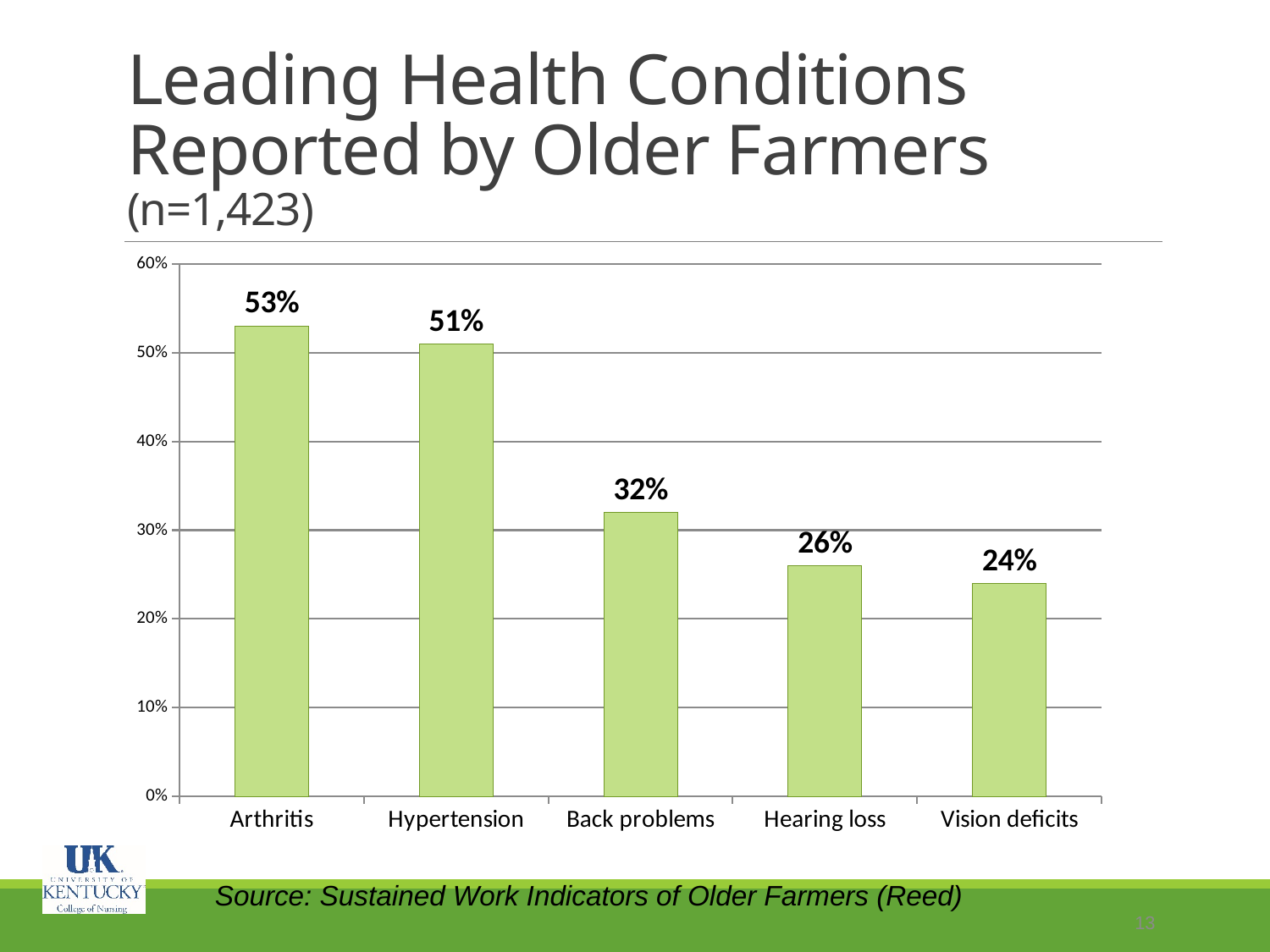
What percentage of older farmers reported arthritis? 53% What is the difference in percentage points between Arthritis and Hypertension? 2 Which is larger, the value for Hearing loss or the value for Vision deficits? Hearing loss Which health condition has the lowest reported percentage? Vision deficits Which health condition has the highest reported percentage? Arthritis What percentage is shown for Back problems? 32% What kind of chart is shown on the slide? Bar chart How many health conditions are shown on the chart? 5 What is the value for Vision deficits? 24% What is the difference in percentage points between Back problems and Hearing loss? 6 What is the value shown for Hypertension? 51% Do the values rise or fall moving from left to right across the categories? Fall